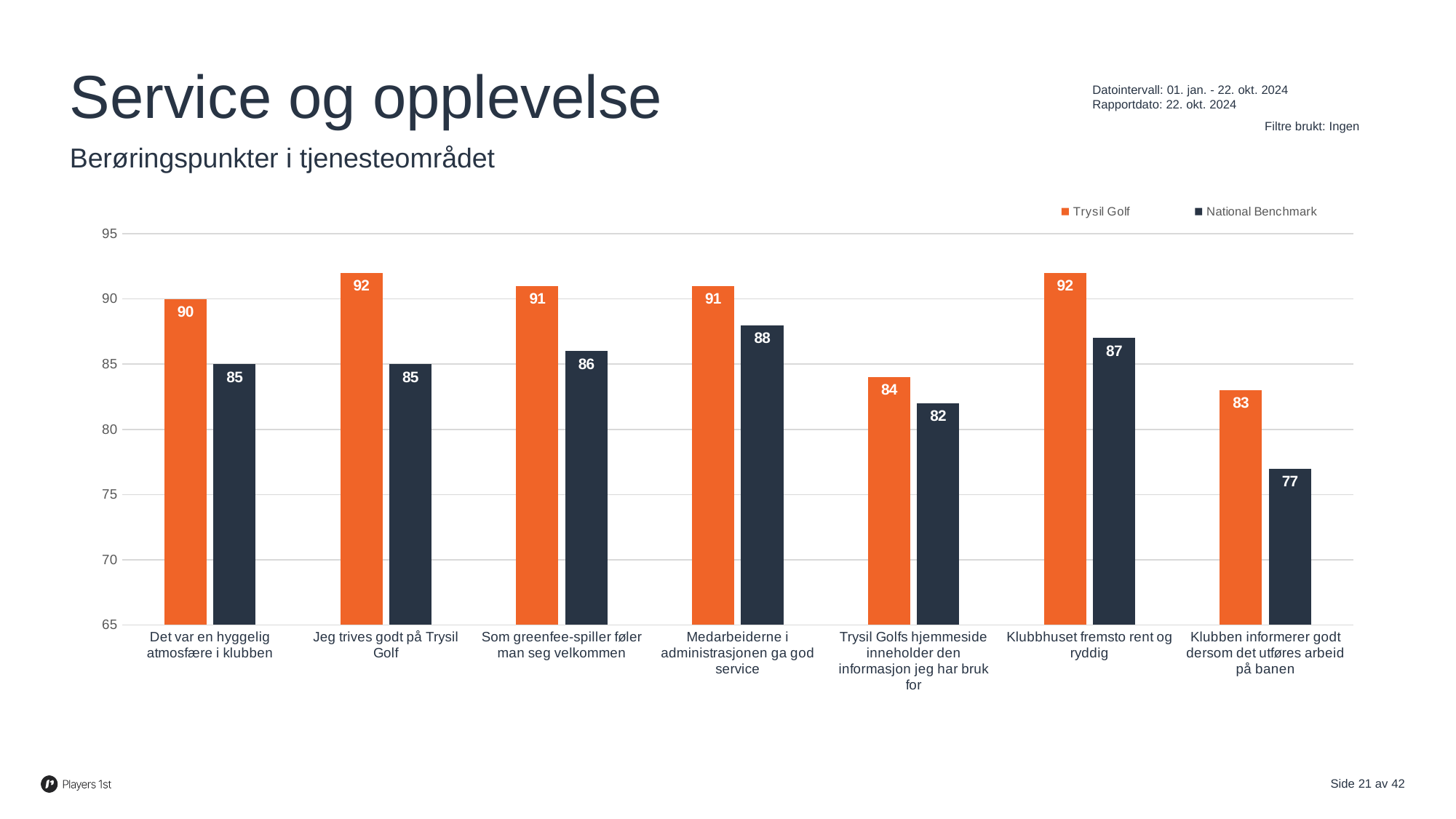
How many series does the legend list? 2 Which is larger for "Trysil Golfs hjemmeside inneholder den informasjon jeg har bruk for": Trysil Golf or National Benchmark? Trysil Golf Which series is shown in orange in the chart? Trysil Golf What is the National Benchmark value for "Medarbeiderne i administrasjonen ga god service"? 88 Which category has the lowest Trysil Golf value? Klubben informerer godt dersom det utføres arbeid på banen How many categories are shown on the x axis of the chart? 7 Which category has the highest National Benchmark value? Medarbeiderne i administrasjonen ga god service What is the National Benchmark value for "Klubben informerer godt dersom det utføres arbeid på banen"? 77 Is the National Benchmark value for "Klubbhuset fremsto rent og ryddig" greater or less than 85? greater What is the Trysil Golf value for "Det var en hyggelig atmosfære i klubben"? 90 What kind of chart is shown on the slide? Bar chart What is the difference between the Trysil Golf and National Benchmark values for "Jeg trives godt på Trysil Golf"? 7